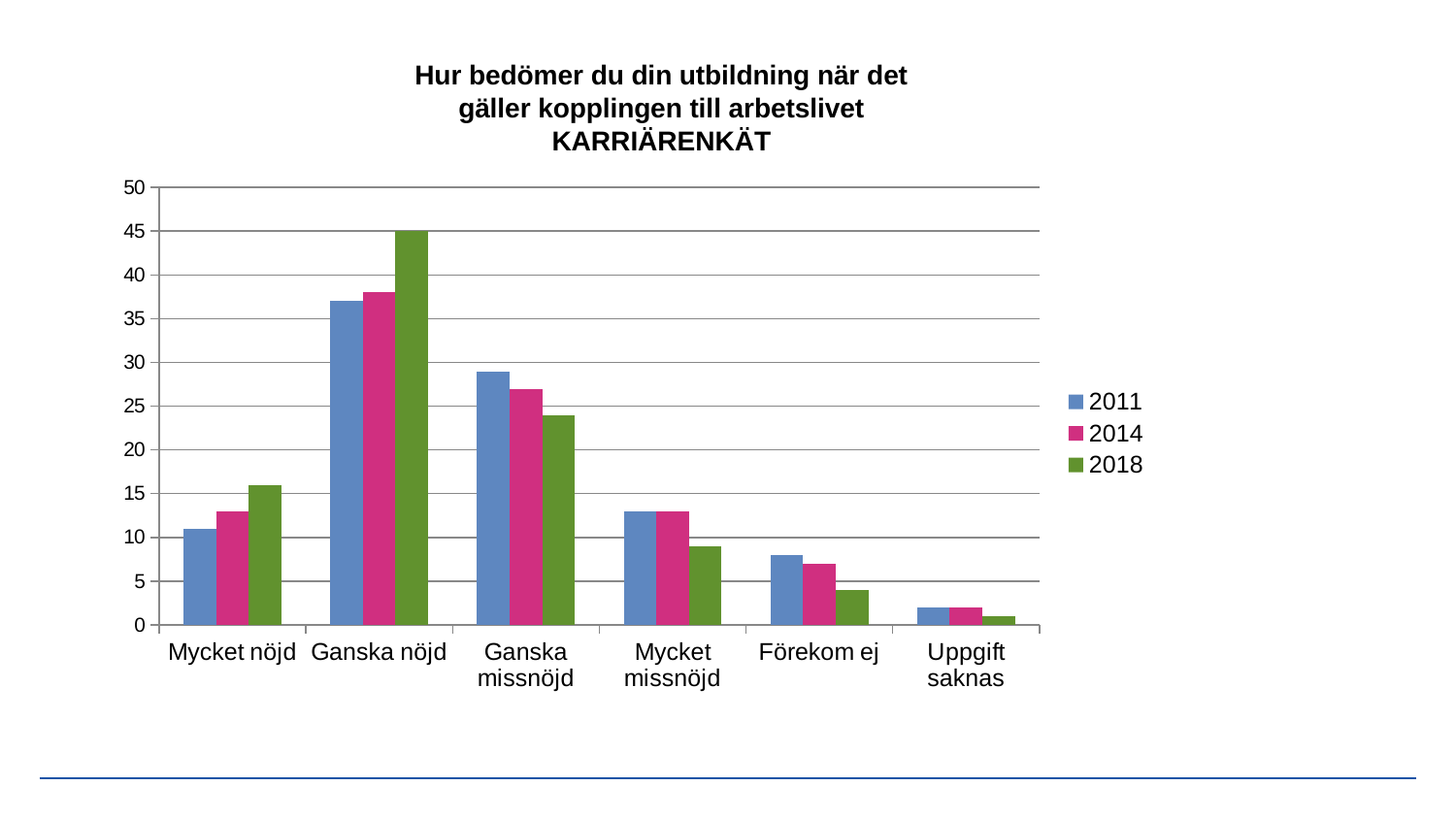
Is the value for Ganska nöjd in 2018 greater or less than 40? greater Which category has the lowest value for 2011? Uppgift saknas Which series is shown in green in the legend? 2018 Which is larger for Mycket nöjd: the 2011 value or the 2018 value? 2018 How many series does the legend list? 3 What kind of chart is shown on the slide? bar chart Is the value for Ganska missnöjd in 2011 greater or less than 25? greater How many categories are shown on the x axis? 6 Which is larger for Ganska missnöjd: the 2011 value or the 2018 value? 2011 Is the value for Mycket nöjd in 2011 greater or less than 15? less Which category has the highest value for 2018? Ganska nöjd